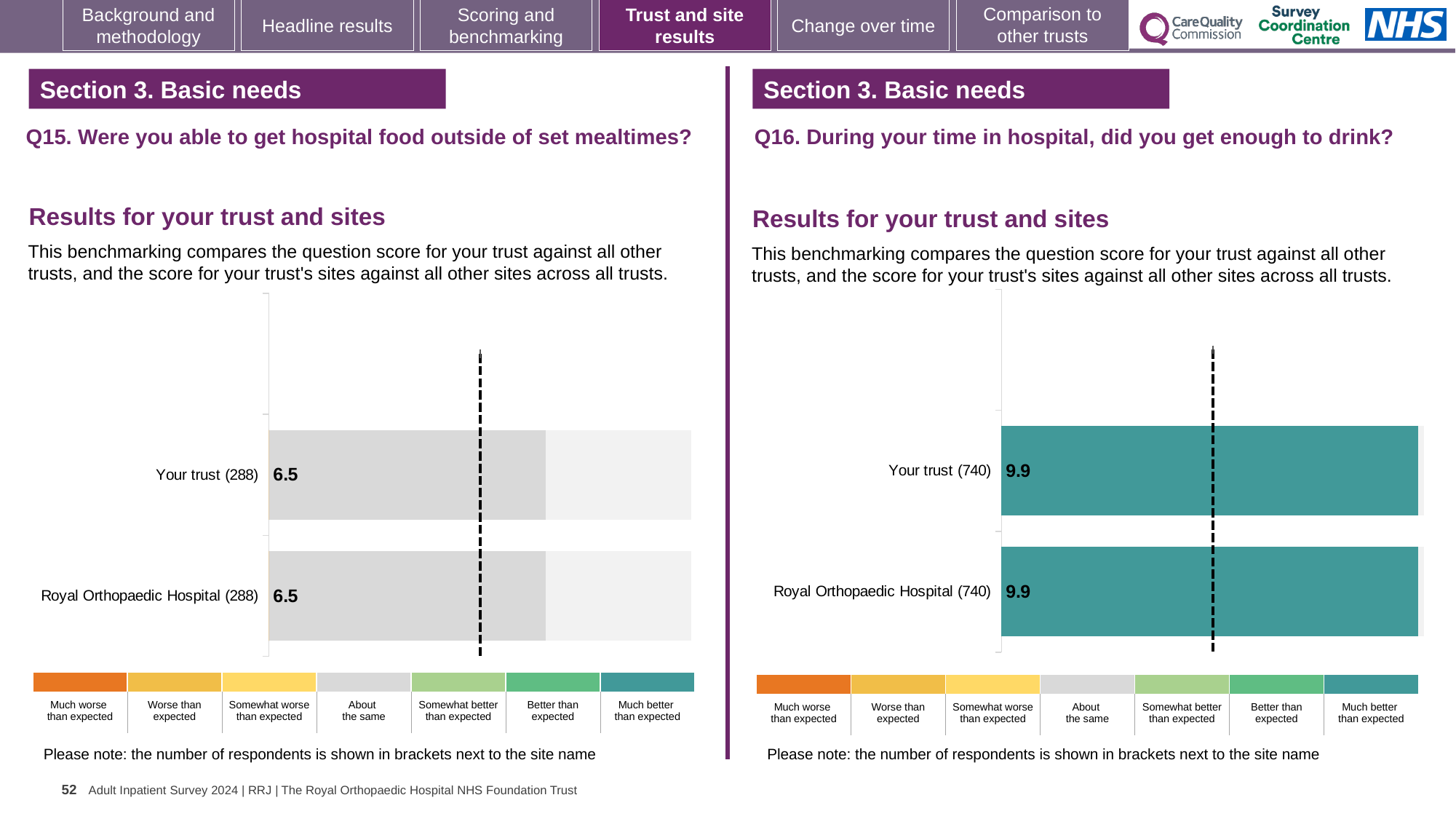
On the Q16 chart (right), what is the score for Royal Orthopaedic Hospital (740)? 9.9 What kind of chart is used on the Q16 chart (right)? Bar chart On the Q16 chart (right), how many bars are plotted? 2 On the Q16 chart (right), what is the score for Your trust (740)? 9.9 On the Q15 chart (left), what is the score for Your trust (288)? 6.5 On the Q15 chart (left), how many respondents are shown in brackets next to Your trust? 288 On the Q16 chart (right), how many benchmark categories does the colour key below the chart list? 7 On the Q15 chart (left), what is the score for Royal Orthopaedic Hospital (288)? 6.5 On the Q15 chart (left), what is the difference between the score for Your trust and the score for Royal Orthopaedic Hospital? 0 On the Q16 chart (right), what is the difference between the score for Your trust and the score for Royal Orthopaedic Hospital? 0 On the Q15 chart (left), how many bars are plotted? 2 On the Q16 chart (right), which benchmark category does the colour of the bars correspond to in the key? Much better than expected